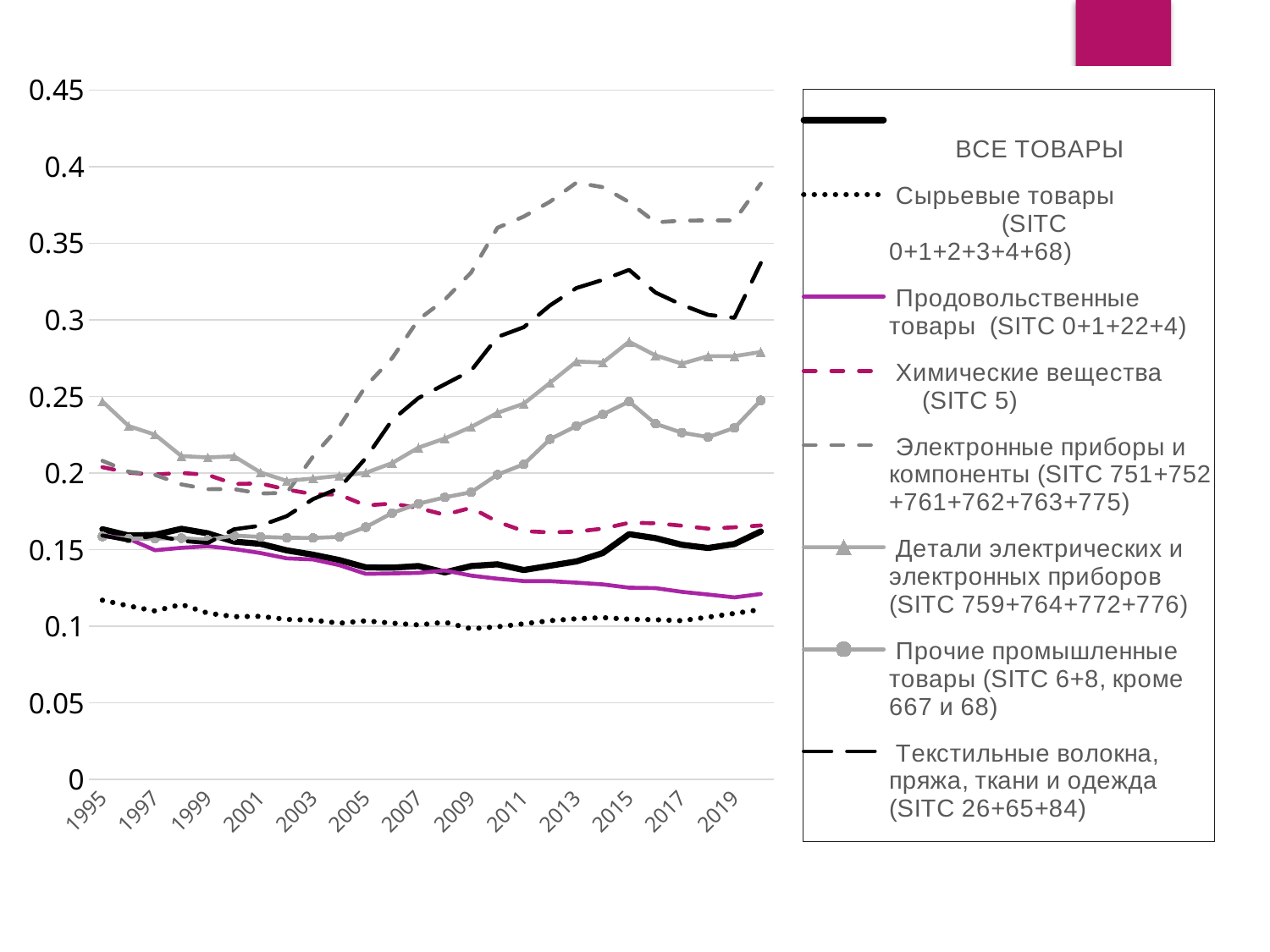
Is the value for Электронные приборы и компоненты in 2013 greater or less than 0.35? greater In 2019, which is higher: Электронные приборы и компоненты or Текстильные волокна, пряжа, ткани и одежда? Электронные приборы и компоненты Which series has the highest value in 2015? Электронные приборы и компоненты Is the value for ВСЕ ТОВАРЫ in 2015 greater or less than 0.2? less How many year labels are shown on the x axis? 13 Which series is drawn with triangle markers? Детали электрических и электронных приборов How many series does the legend list? 8 Is the value for Сырьевые товары in 2009 greater or less than 0.15? less What kind of chart is shown on the slide? line chart Which series has the lowest value in 2015? Сырьевые товары Does the line for Продовольственные товары rise or fall between 1995 and 2019? fall Does the line for Электронные приборы и компоненты rise or fall between 2003 and 2013? rise